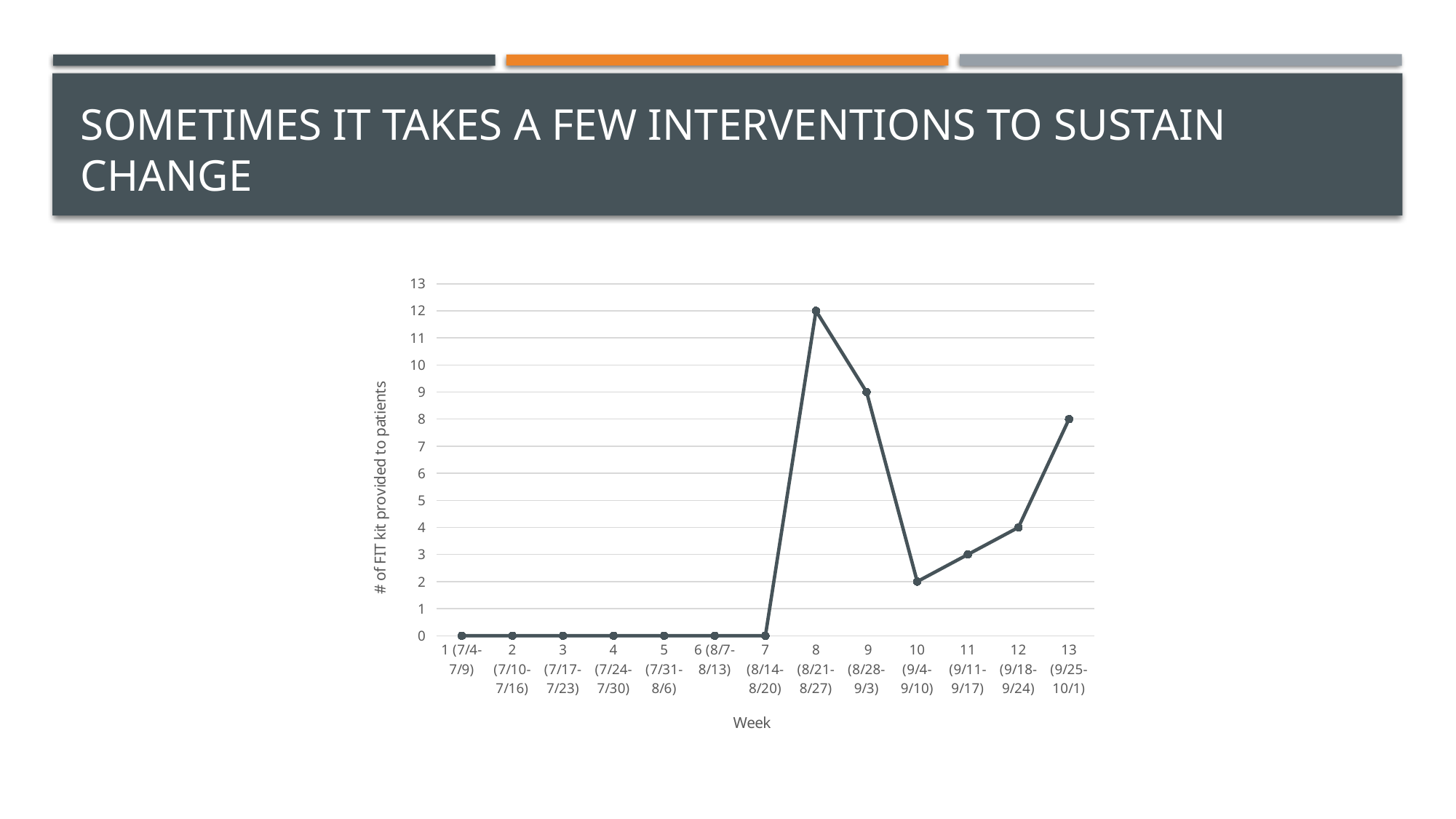
What is the label of the y axis? # of FIT kit provided to patients What is the difference between the number of FIT kits provided in week 8 and week 9? 3 Which week has the highest number of FIT kits provided to patients? 8 (8/21-8/27) Which week has more FIT kits provided to patients, week 12 or week 13? 13 (9/25-10/1) What is the number of FIT kits provided to patients in week 13 (9/25-10/1)? 8 What is the number of FIT kits provided to patients in week 8 (8/21-8/27)? 12 Do the values rise or fall from week 10 to week 13? rise How many weeks are plotted on the x axis? 13 What is the number of FIT kits provided to patients in week 9 (8/28-9/3)? 9 Is the value for week 11 (9/11-9/17) greater or less than 5? less What kind of chart is shown on the slide? line chart What is the number of FIT kits provided to patients in week 10 (9/4-9/10)? 2